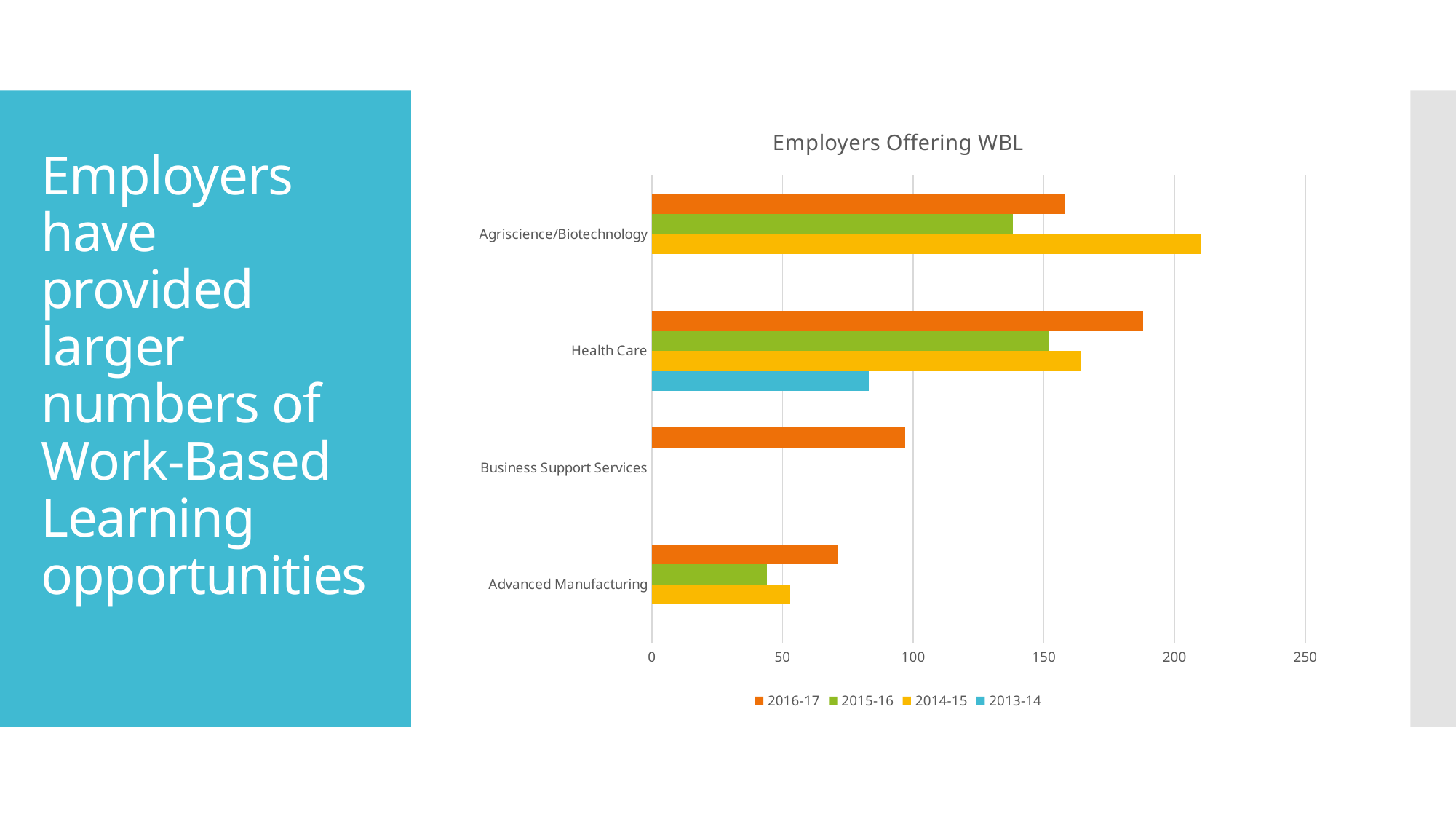
How many series does the legend list? 4 For Agriscience/Biotechnology, which is larger: the 2014-15 value or the 2016-17 value? 2014-15 What is the title of the chart? Employers Offering WBL Which category has the lowest 2016-17 value? Advanced Manufacturing Which has the larger 2016-17 value: Health Care or Agriscience/Biotechnology? Health Care Is the 2014-15 value for Agriscience/Biotechnology greater or less than 200? greater Which category has the highest 2016-17 value? Health Care How many categories are shown on the chart? 4 What kind of chart is shown on the slide? bar chart Which category has a bar for only one series? Business Support Services Is the 2013-14 value for Health Care greater or less than 100? less